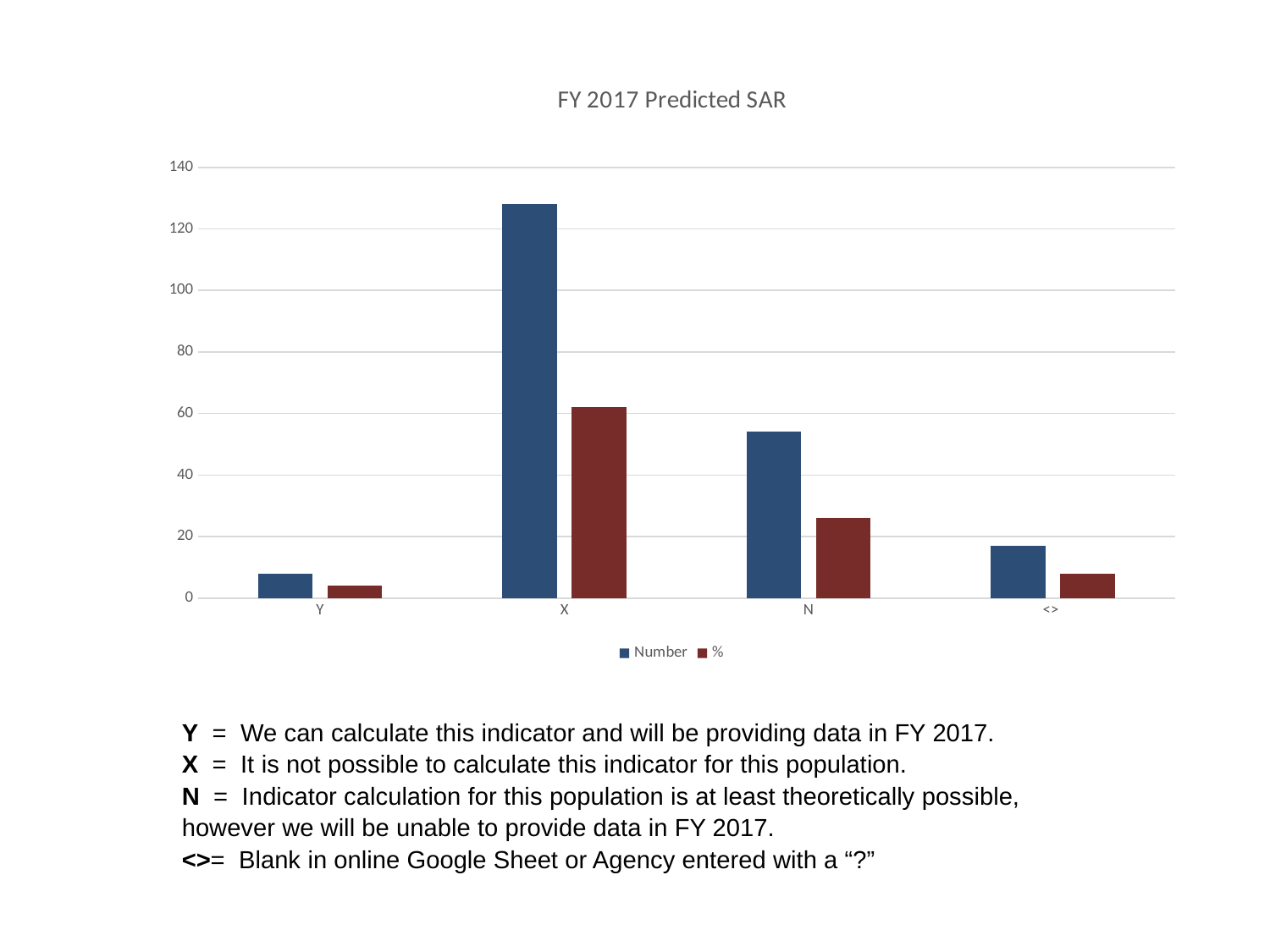
Which category has the highest % value? X What is the title of the chart? FY 2017 Predicted SAR Is the Number value for X greater or less than 120? greater How many categories are shown on the x axis? 4 Which category has the lowest Number value? Y Is the Number value for N greater or less than 40? greater Which category has the highest Number value? X What kind of chart is shown on the slide? bar chart Is the Number value for Y greater or less than 20? less How many series does the legend list? 2 Which is larger, the Number value for N or the Number value for <>? N